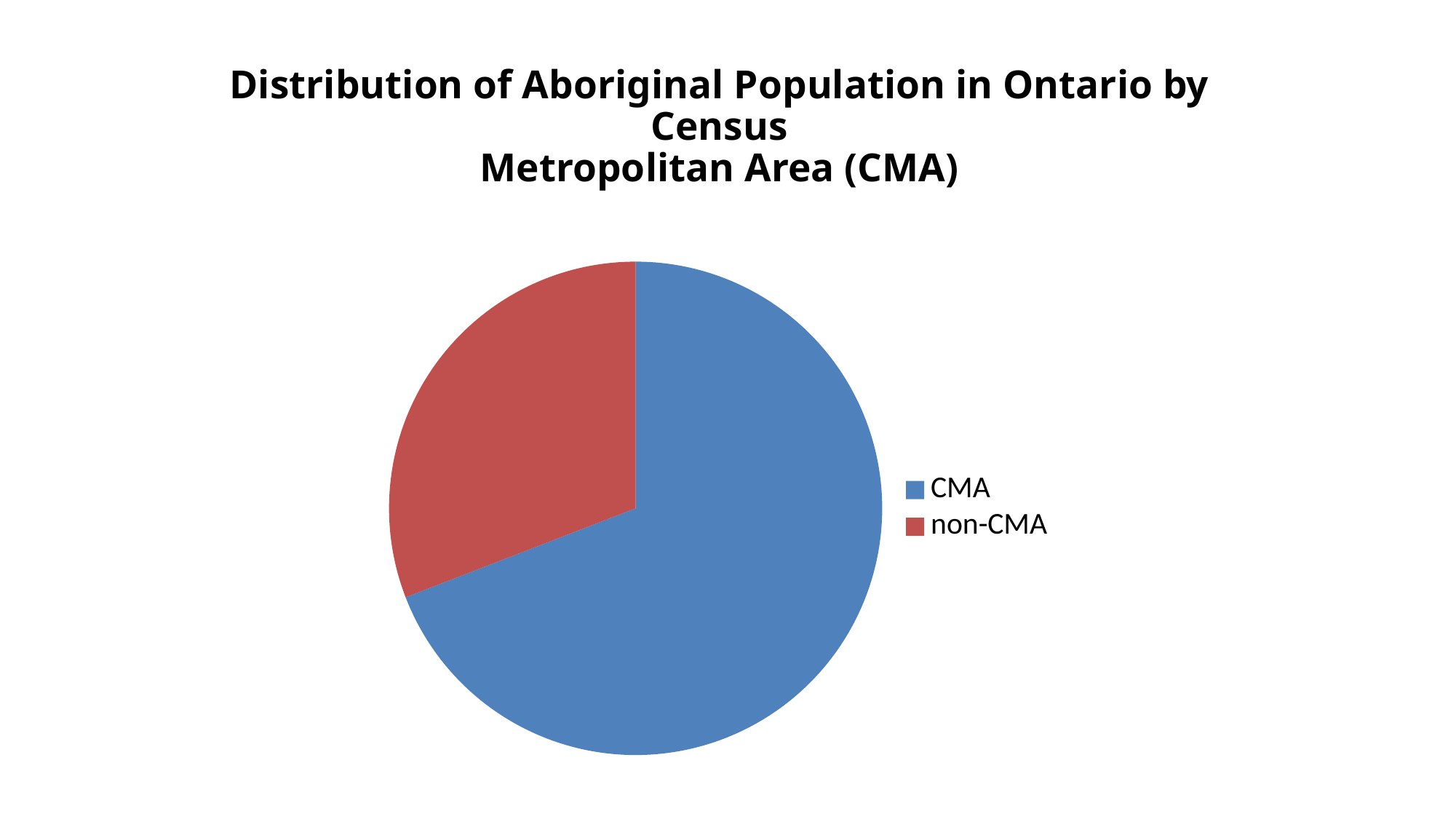
Is the share of the pie for CMA greater or less than 50%? greater Which slice is larger, CMA or non-CMA? CMA Is the share of the pie for non-CMA greater or less than 50%? less What is the title of the chart? Distribution of Aboriginal Population in Ontario by Census Metropolitan Area (CMA) What kind of chart is shown on the slide? pie chart How many entries does the legend list? 2 Which category has the largest slice of the pie? CMA What colour is the non-CMA slice? red How many slices does the pie chart have? 2 Which category has the smallest slice of the pie? non-CMA